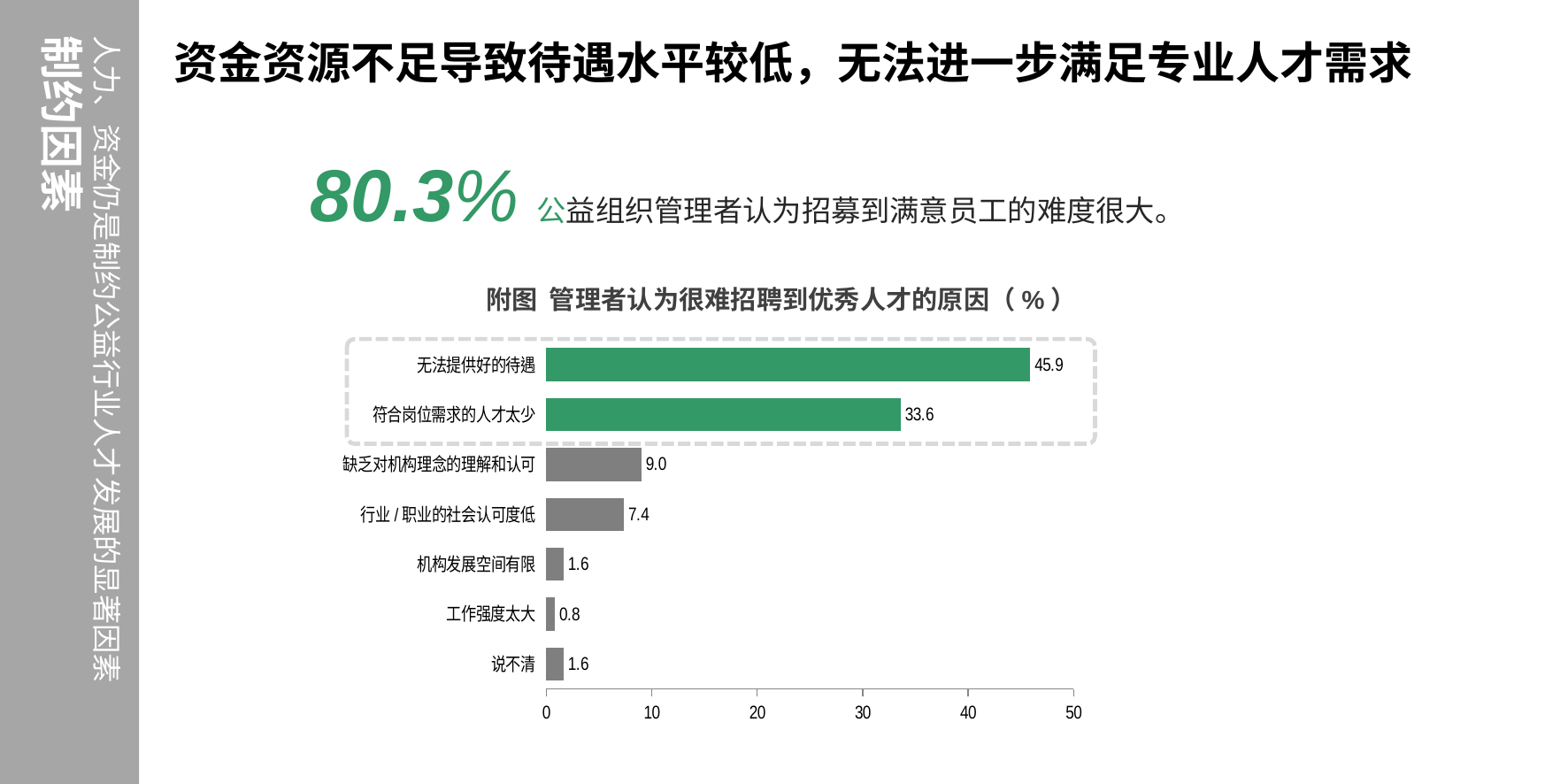
What is the value for 工作强度太大? 0.8 What is the title of the chart? 附图 管理者认为很难招聘到优秀人才的原因（%） Is the value for 符合岗位需求的人才太少 greater or less than 30? greater Which is larger, the value for 缺乏对机构理念的理解和认可 or the value for 行业 / 职业的社会认可度低? 缺乏对机构理念的理解和认可 What is the difference between the values for 无法提供好的待遇 and 符合岗位需求的人才太少? 12.3 Which category has the lowest value? 工作强度太大 What kind of chart is shown on the slide? bar chart How many categories are shown in the chart? 7 Which category has the highest value? 无法提供好的待遇 What is the value for 无法提供好的待遇? 45.9 What is the value for 行业 / 职业的社会认可度低? 7.4 What is the value for 符合岗位需求的人才太少? 33.6